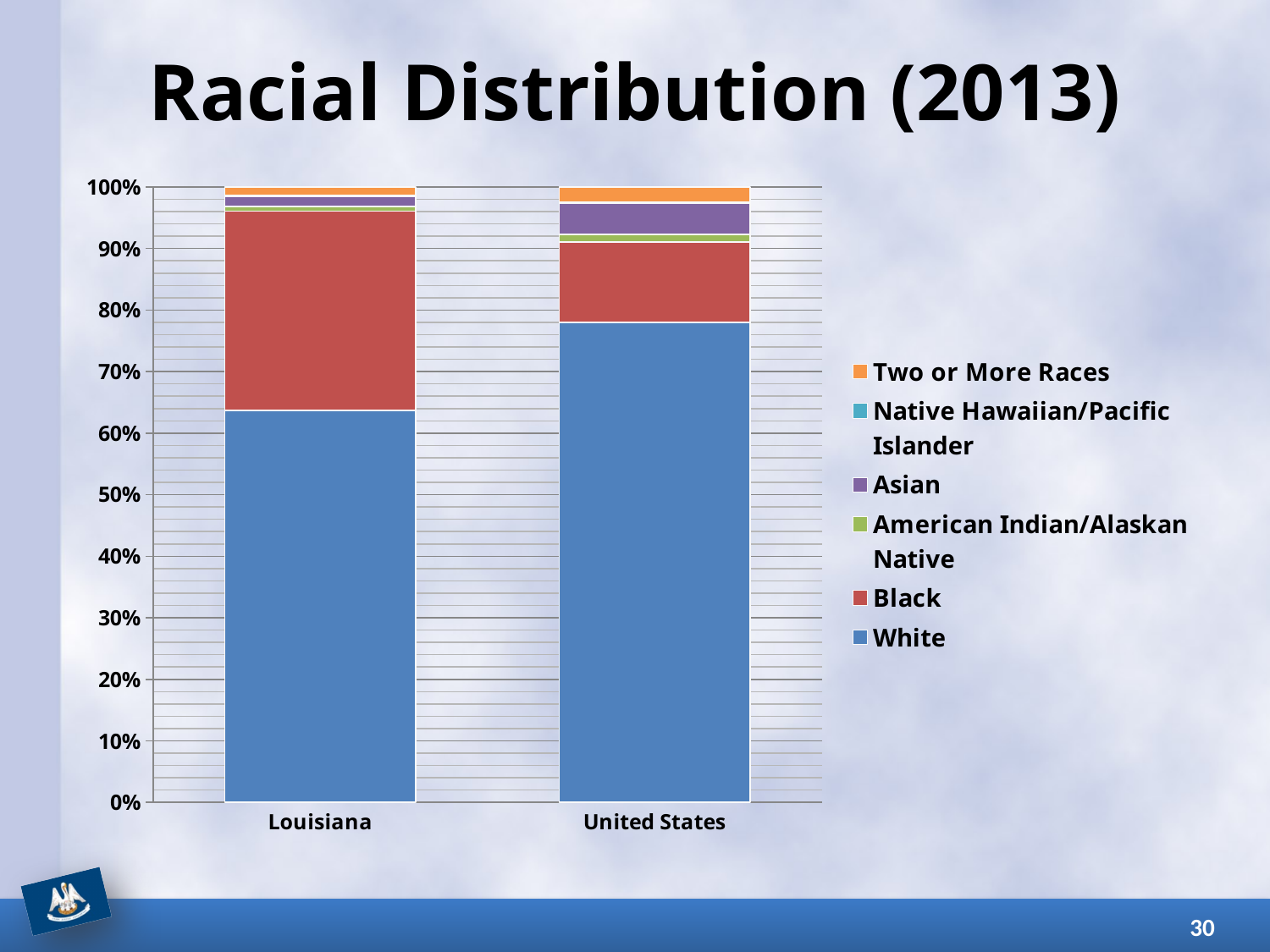
What is the title of the chart on the slide? Racial Distribution (2013) Which category has the larger White share, Louisiana or the United States? United States How many categories are shown on the x axis of the chart? 2 What kind of chart is shown on the slide? Stacked bar chart Which category has the larger Black share, Louisiana or the United States? Louisiana Is the White share for the United States greater or less than 80%? less Is the White share for Louisiana greater or less than 60%? greater Is the White share for Louisiana greater or less than 70%? less Which colour represents the White series in the chart? Blue How many series does the chart's legend list? 6 Which category has the larger Asian share, Louisiana or the United States? United States